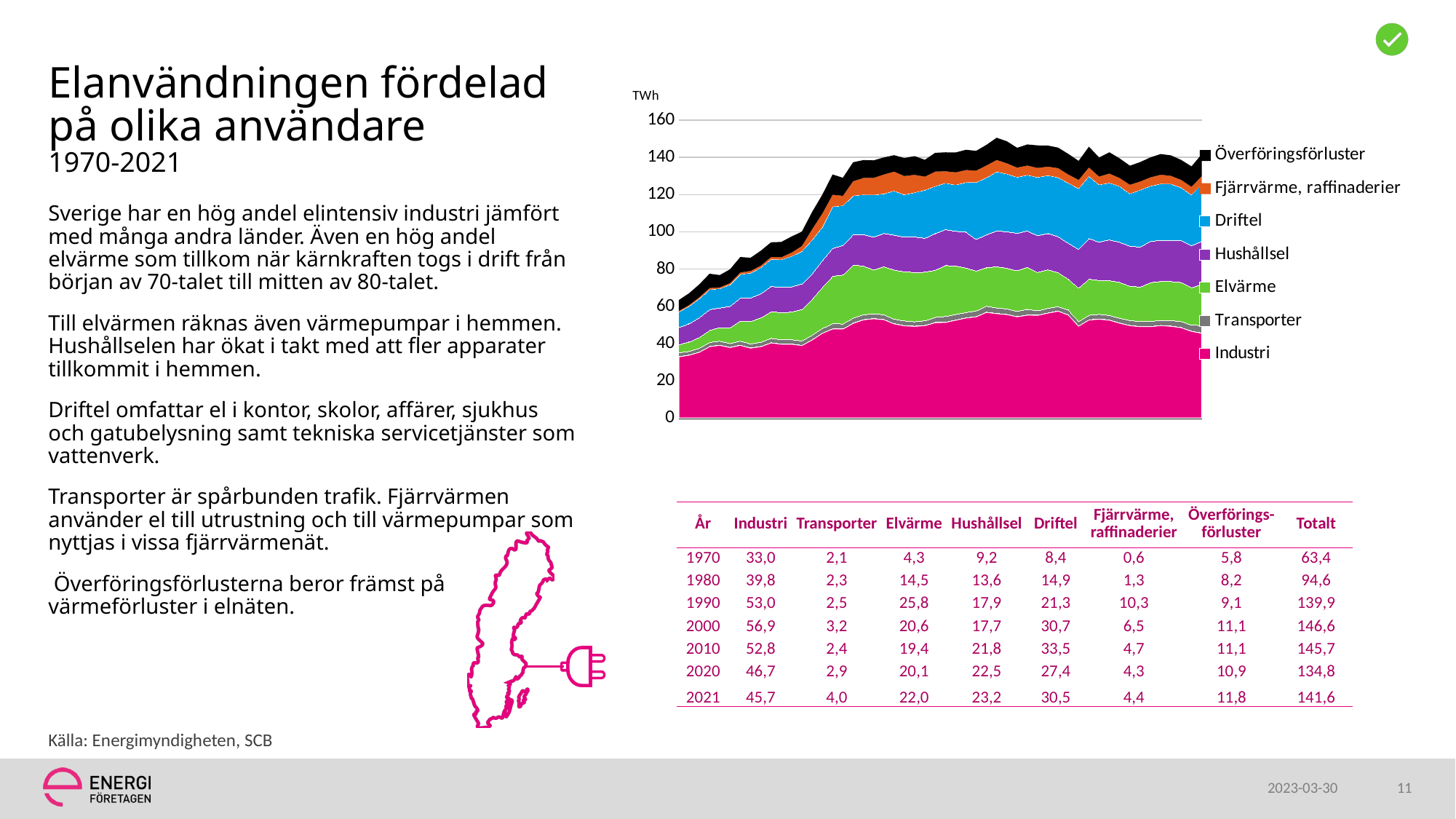
Which year in the table has the highest Totalt value? 2000 According to the table, what was the total (Totalt) electricity use in 2021? 141,6 According to the table, what was the value for Industri in 1970? 33,0 Is the total electricity use in 1970 greater or less than 80 TWh? less In 2021, which is larger according to the table: Hushållsel or Elvärme? Hushållsel According to the table, what was the value for Driftel in 2010? 33,5 What unit is shown on the vertical axis of the chart? TWh What is the difference between the Totalt values for 1990 and 1970 in the table? 76,5 What kind of chart is shown on the slide? Stacked area chart How many series does the chart legend list? 7 Which year in the table has the lowest Totalt value? 1970 Which series is shown at the bottom of the stacked area chart? Industri